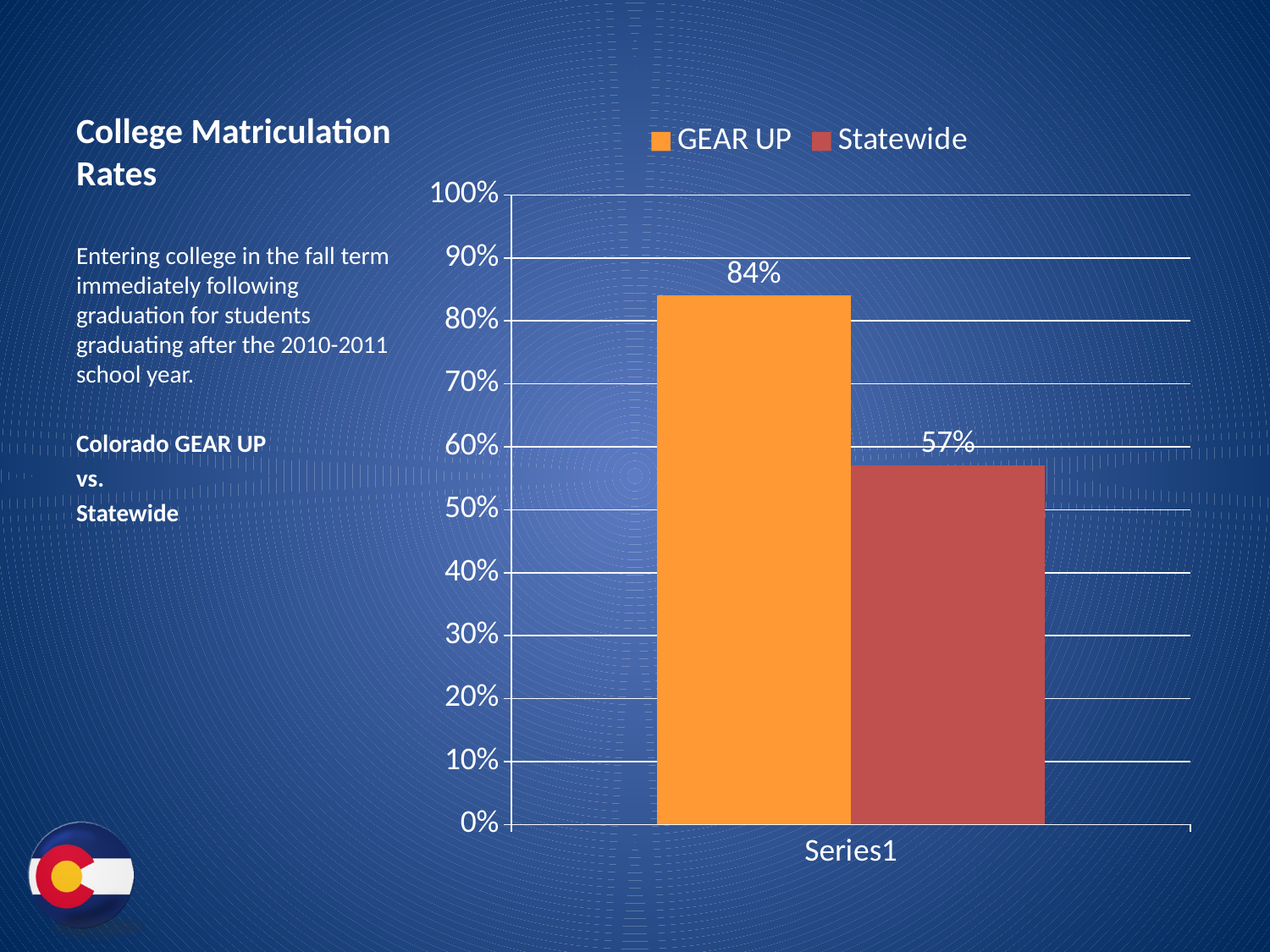
Which series has the highest value? GEAR UP What kind of chart is shown on the slide? bar chart What is the difference between the GEAR UP value and the Statewide value? 27% Is the value for GEAR UP greater or less than 80%? greater What colour is the GEAR UP bar? orange What is the value for Statewide? 57% Which series has the lowest value? Statewide Is the value for Statewide greater or less than 60%? less What is the label on the x axis under the bars? Series1 How many series does the legend list? 2 What is the value for GEAR UP? 84% Which series has the higher value, GEAR UP or Statewide? GEAR UP